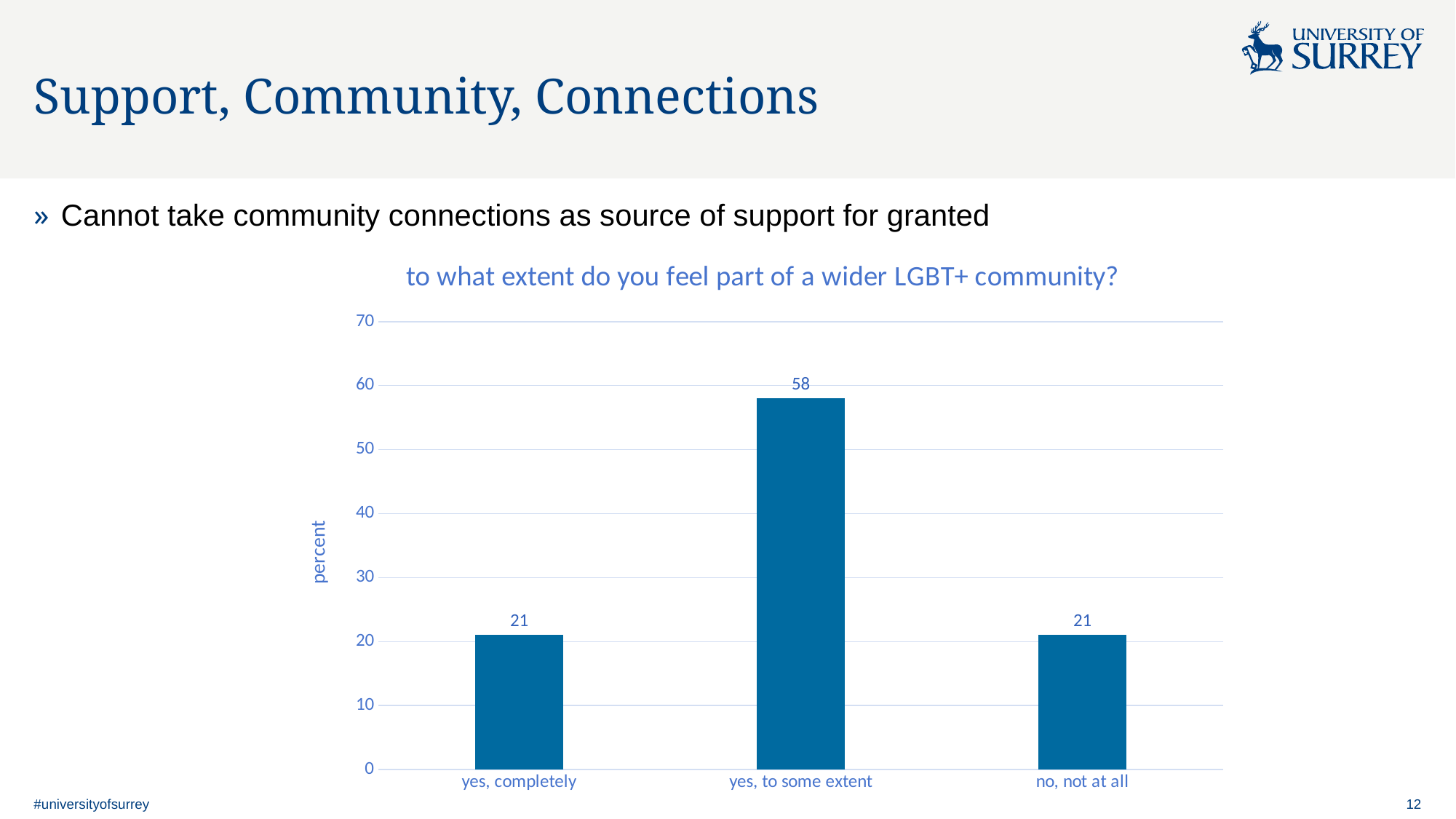
Is the value for "yes, to some extent" greater or less than 50? greater Which category has the highest value? yes, to some extent How many categories are shown on the x axis? 3 What is the difference between the values for "yes, to some extent" and "yes, completely"? 37 What is the label on the vertical axis? percent What is the value for "yes, completely"? 21 What is the value for "yes, to some extent"? 58 What kind of chart is shown on the slide? bar chart What is the value for "no, not at all"? 21 Is the value for "no, not at all" greater or less than 30? less What is the title of the chart? to what extent do you feel part of a wider LGBT+ community? Which is larger, the value for "yes, to some extent" or the value for "no, not at all"? yes, to some extent